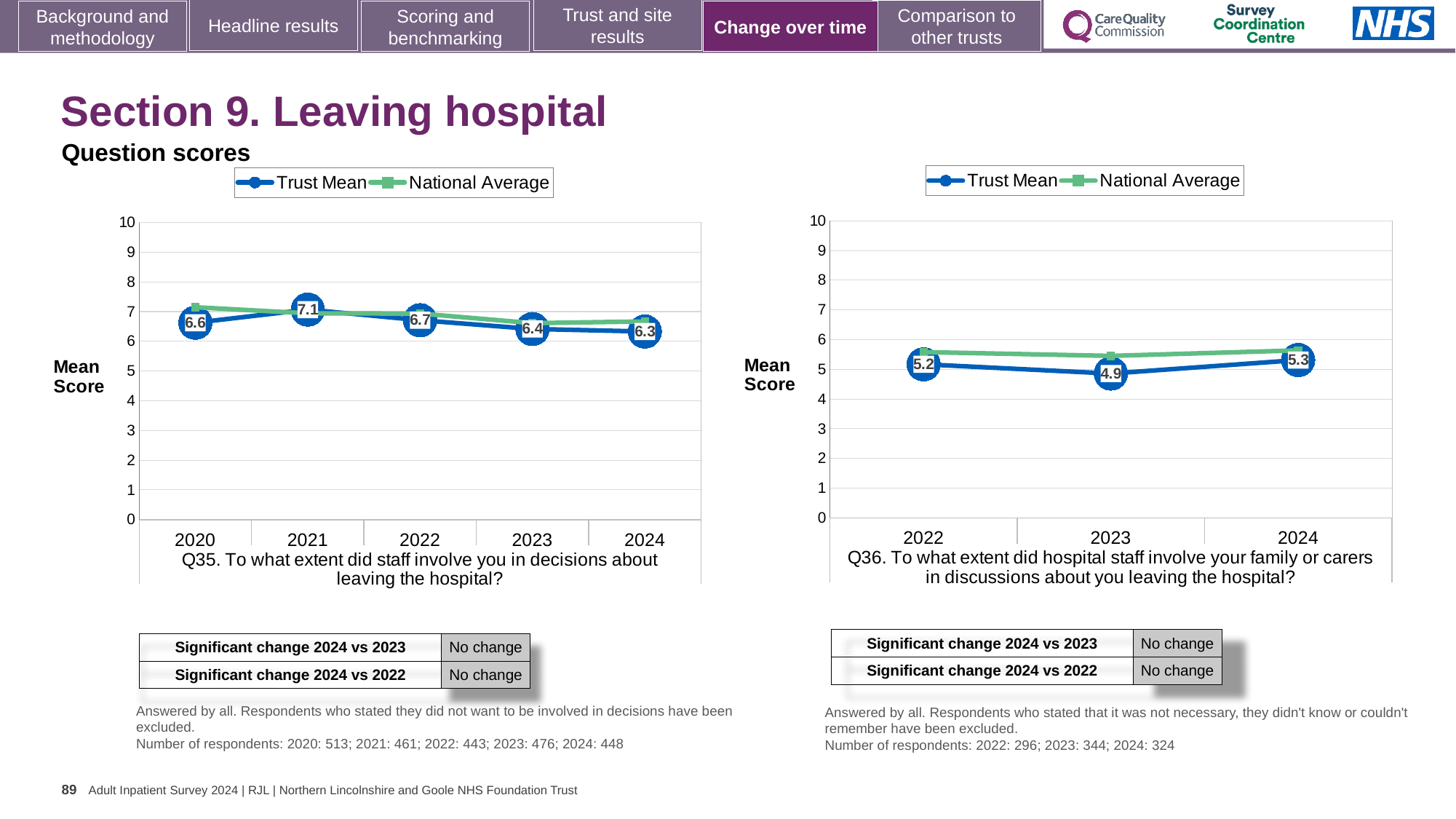
How many series does the legend of the Q36 chart (right) list? 2 In the Q35 chart (left), which year has the lowest Trust Mean score? 2024 In the Q35 chart (left), how many years are shown on the x axis? 5 In the Q35 chart (left), what is the difference between the Trust Mean scores for 2021 and 2024? 0.8 In the Q36 chart (right), is the National Average for 2023 greater or less than 6? less What type of chart is the Q35 chart (left)? Line chart In the Q35 chart (left), which year has the highest Trust Mean score? 2021 In the Q35 chart (left), what is the Trust Mean score for 2024? 6.3 In the Q36 chart (right), is the Trust Mean score for 2022 or 2024 larger? 2024 In the Q36 chart (right), which year has the highest Trust Mean score? 2024 In the Q35 chart (left), what is the Trust Mean score for 2021? 7.1 In the Q36 chart (right), what is the Trust Mean score for 2023? 4.9